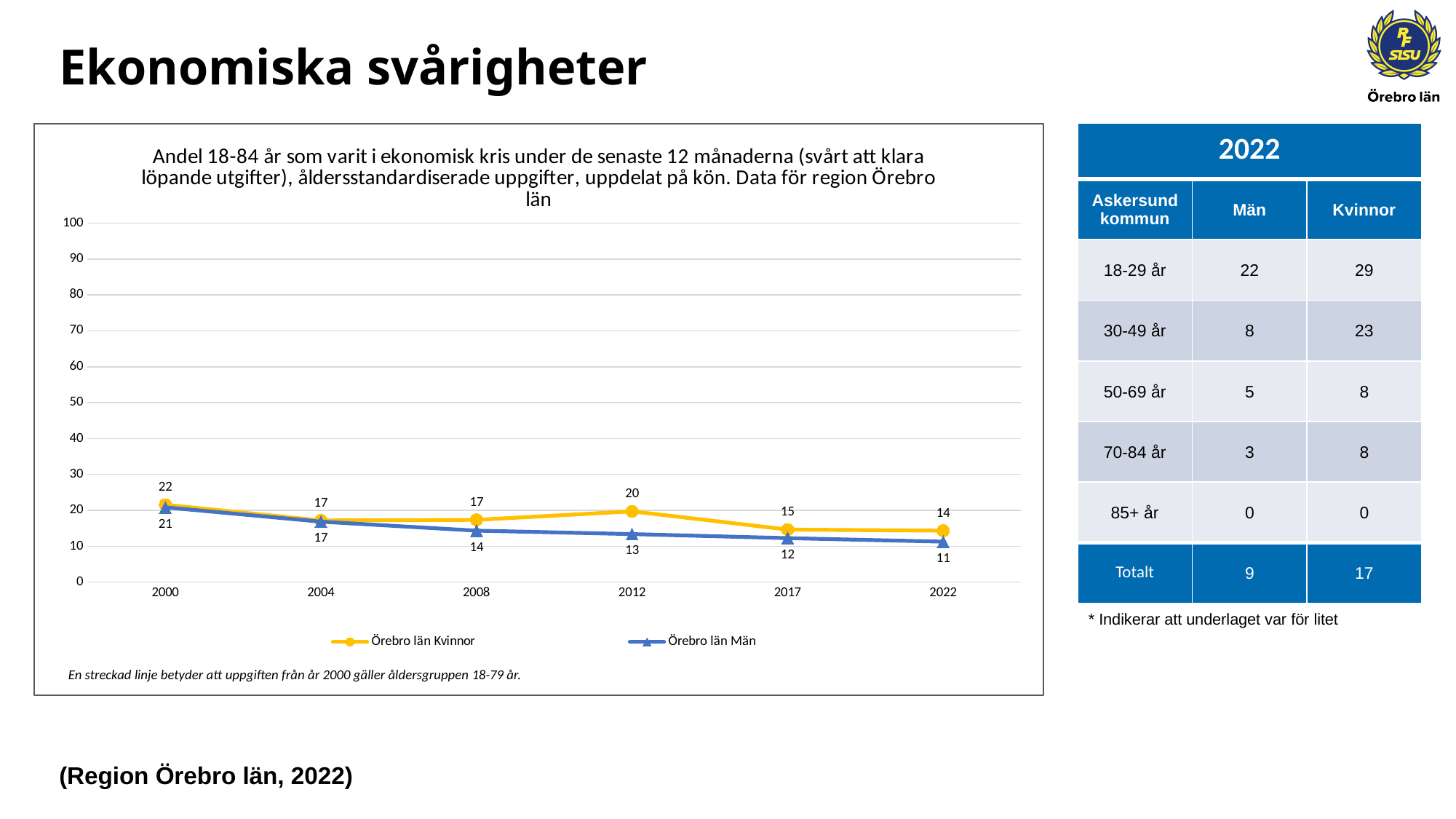
In which year is the value for Örebro län Män lowest? 2022 What is the difference between Örebro län Kvinnor and Örebro län Män in 2012? 7 How many years are plotted on the x axis of the chart? 6 Does the value for Örebro län Män rise or fall from 2000 to 2022? fall In which year is the value for Örebro län Kvinnor highest? 2000 Which series has the larger value in 2017, Örebro län Kvinnor or Örebro län Män? Örebro län Kvinnor Which colour is used for the Örebro län Kvinnor line in the chart? yellow What is the value for Örebro län Män in 2022? 11 What is the value for Örebro län Män in 2008? 14 How many series does the chart legend list? 2 What is the value for Örebro län Kvinnor in 2012? 20 What type of chart is shown on the slide? line chart